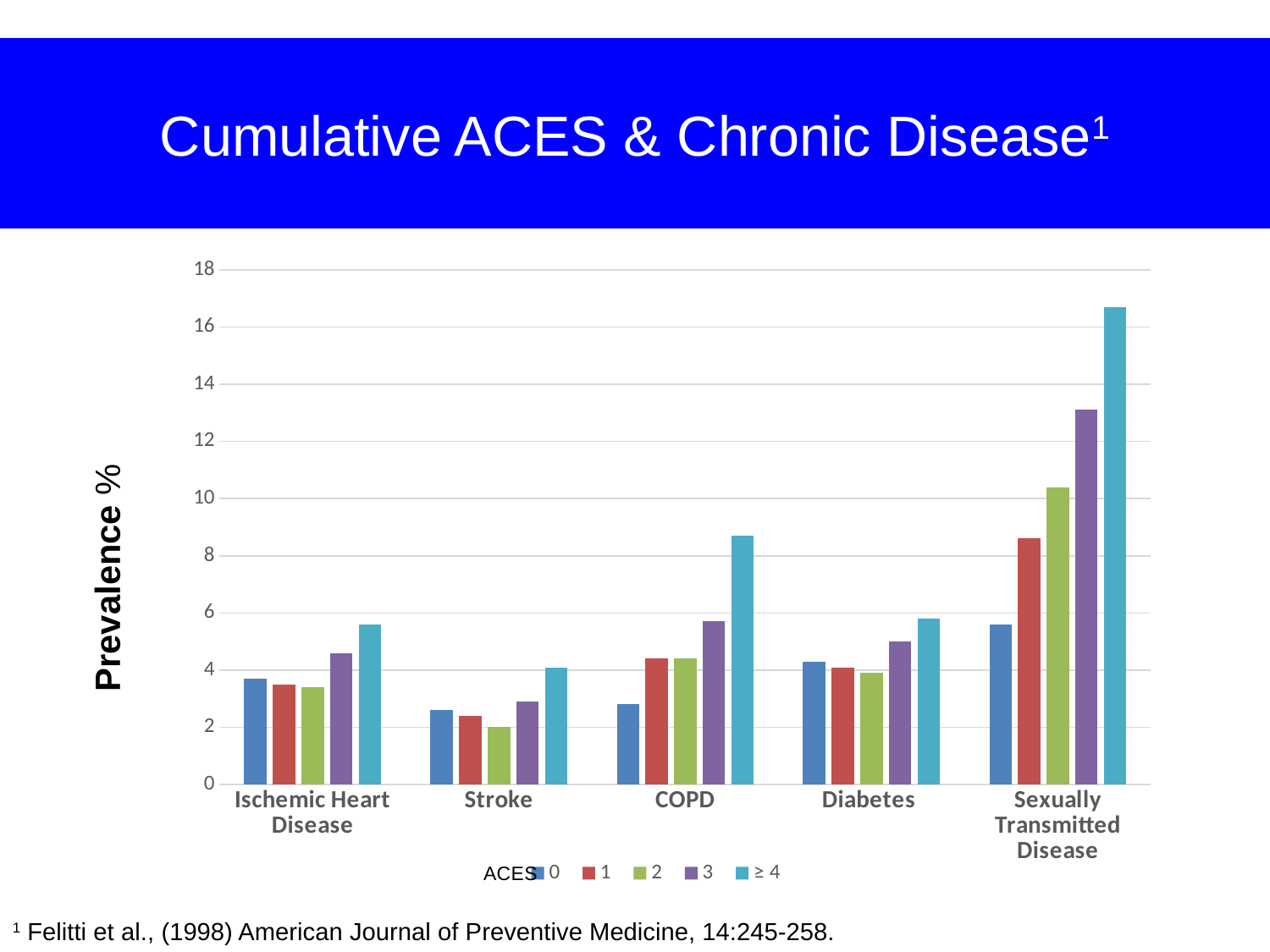
Is the value for the ≥ 4 ACES group in COPD greater or less than 8? greater How many disease categories are shown on the x axis? 5 Within the Stroke category, which ACES group has the lowest prevalence? 2 What kind of chart is shown on the slide? bar chart What is the label on the y axis of the chart? Prevalence % Is the value for the ≥ 4 ACES group in Ischemic Heart Disease greater or less than 6? less Which is larger: the ≥ 4 ACES value for COPD or the ≥ 4 ACES value for Diabetes? COPD Within the Sexually Transmitted Disease category, which ACES group has the highest prevalence? ≥ 4 Is the value for the ≥ 4 ACES group in Sexually Transmitted Disease greater or less than 16? greater Which disease category has the highest bar in the chart? Sexually Transmitted Disease How many series does the legend list? 5 In the Sexually Transmitted Disease category, do the values rise or fall as the number of ACES increases from 0 to ≥ 4? rise